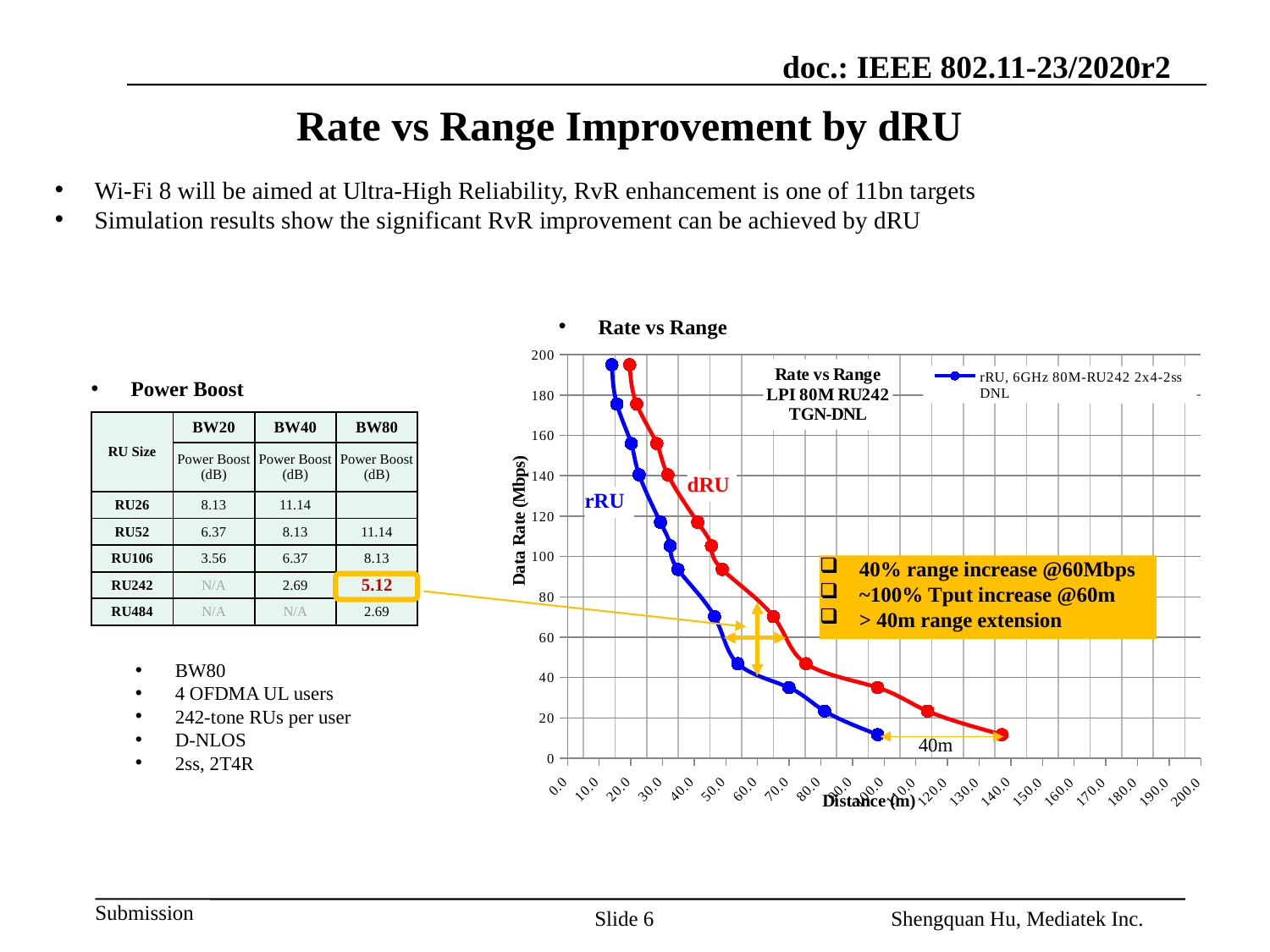
What is the title of the chart? Rate vs Range LPI 80M RU242 TGN-DNL At a distance of about 60 m, which series has the higher data rate, rRU or dRU? dRU How does the data rate change as distance increases along the x axis? It falls Is the data rate of the last rRU point (at about 100 m) greater or less than 20 Mbps? less Is the data rate of the first rRU point (at about 20 m) greater or less than 180 Mbps? greater Is the dRU data rate at about 100 m greater or less than 60 Mbps? less Which series, rRU or dRU, reaches the greater distance before its line ends? dRU What is the label of the vertical axis of the chart? Data Rate (Mbps) What kind of chart is shown on the slide? line chart What is the highest value shown on the vertical axis of the chart? 200